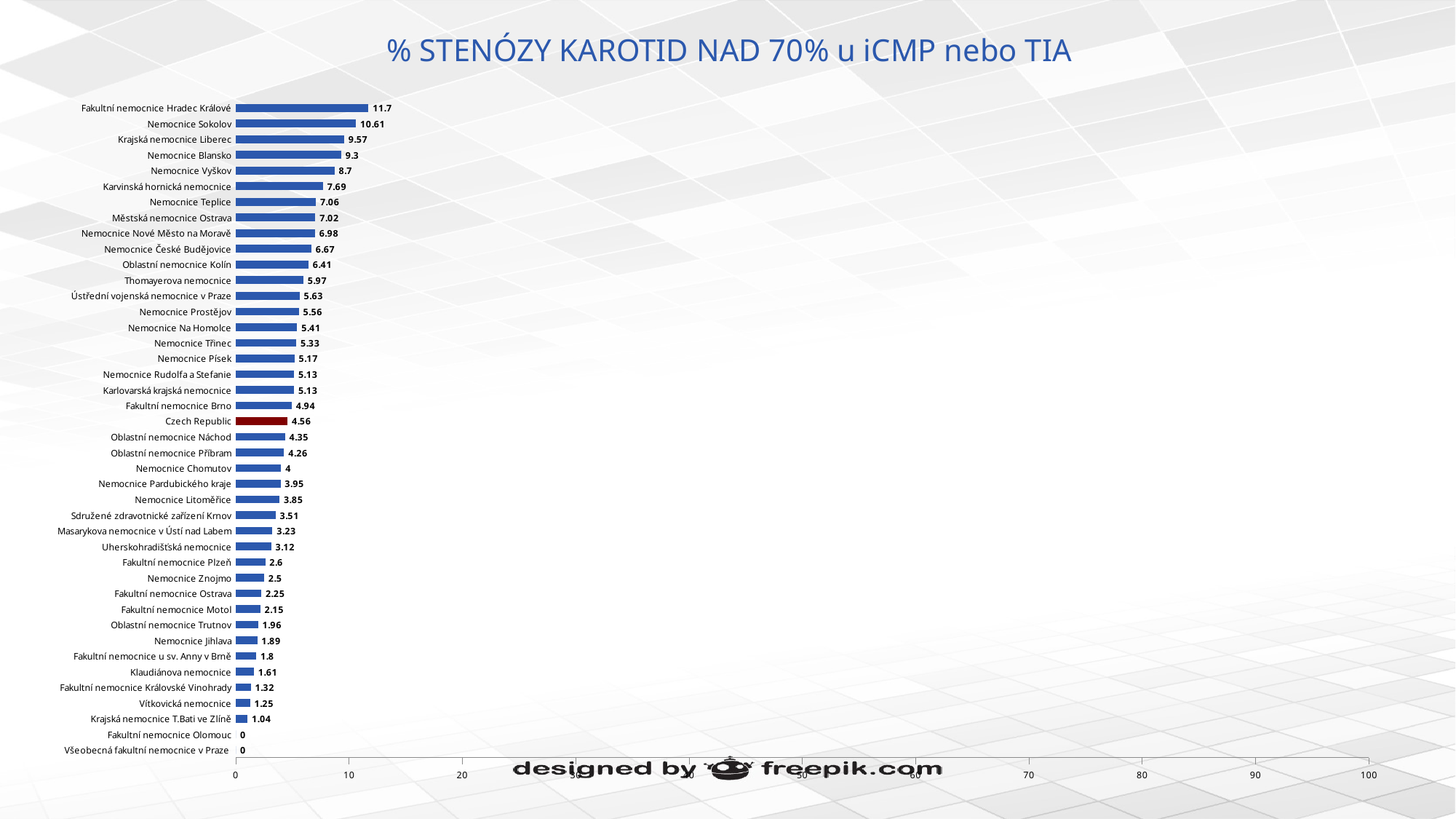
Which category has the highest value? Fakultní nemocnice Hradec Králové What kind of chart is shown on the slide? bar chart What is the difference between the values for Fakultní nemocnice Hradec Králové and Nemocnice Sokolov? 1.09 Which category's bar is coloured dark red instead of blue? Czech Republic What is the value for Nemocnice Sokolov? 10.61 What is the value for Czech Republic? 4.56 What is the value for Fakultní nemocnice Motol? 2.15 Is the value for Krajská nemocnice Liberec greater or less than 10? less How many categories are shown in the chart? 42 Which is larger, the value for Nemocnice Teplice or the value for Nemocnice Chomutov? Nemocnice Teplice What is the title of the chart? % STENÓZY KAROTID NAD 70% u iCMP nebo TIA What is the value for Fakultní nemocnice Hradec Králové? 11.7